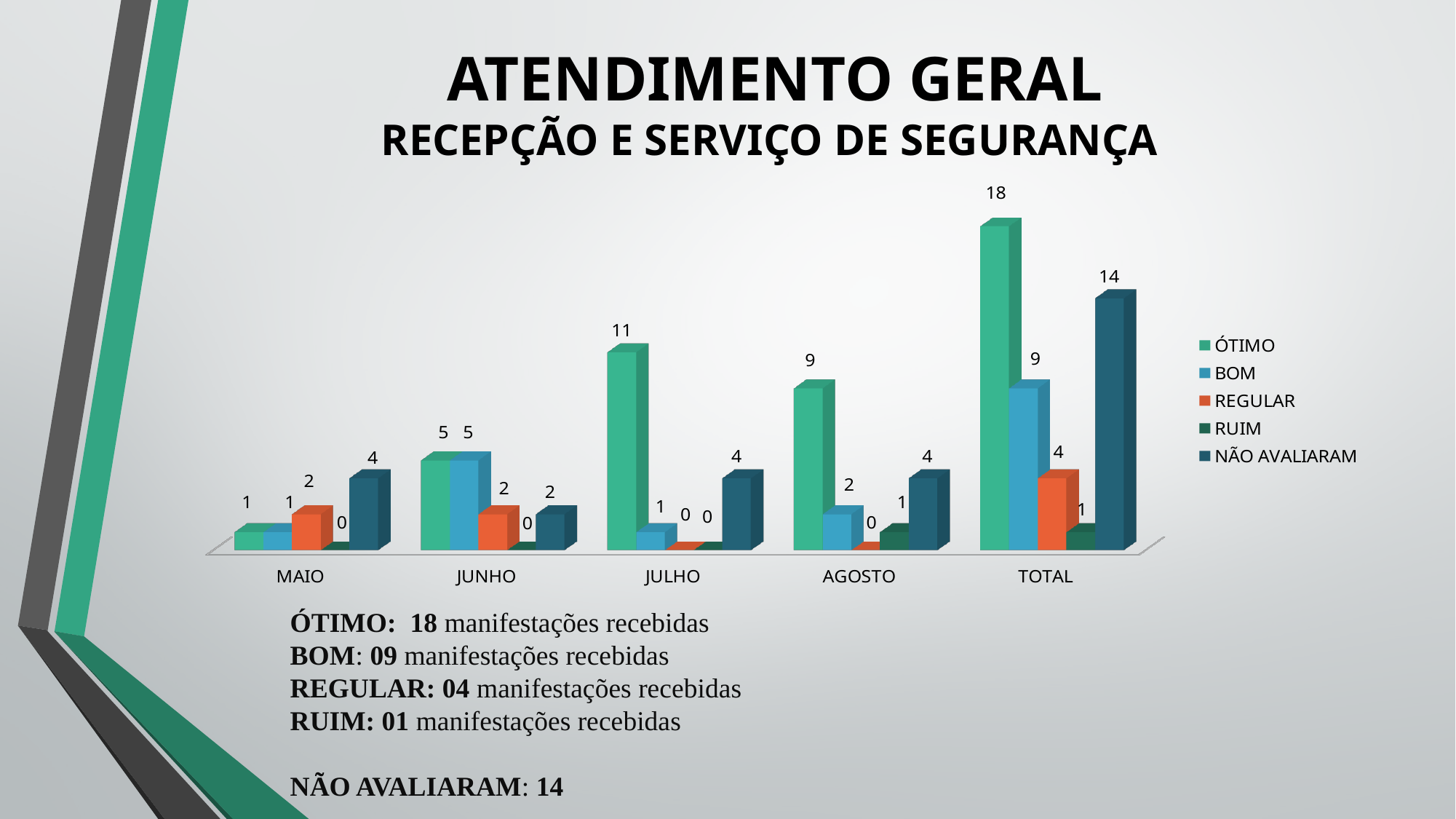
What is the value for BOM in JUNHO? 5 What is the value for REGULAR in MAIO? 2 Which month has the highest ÓTIMO value (excluding TOTAL)? JULHO Which is larger in AGOSTO: ÓTIMO or NÃO AVALIARAM? ÓTIMO Which series has the lowest value in the TOTAL category? RUIM What is the value for NÃO AVALIARAM in TOTAL? 14 Does the ÓTIMO value rise or fall from MAIO to JULHO? Rise What is the value for ÓTIMO in JULHO? 11 What is the difference between the ÓTIMO and BOM values in TOTAL? 9 What kind of chart is shown on the slide? Bar chart How many series does the legend list? 5 How many categories are shown on the x axis? 5